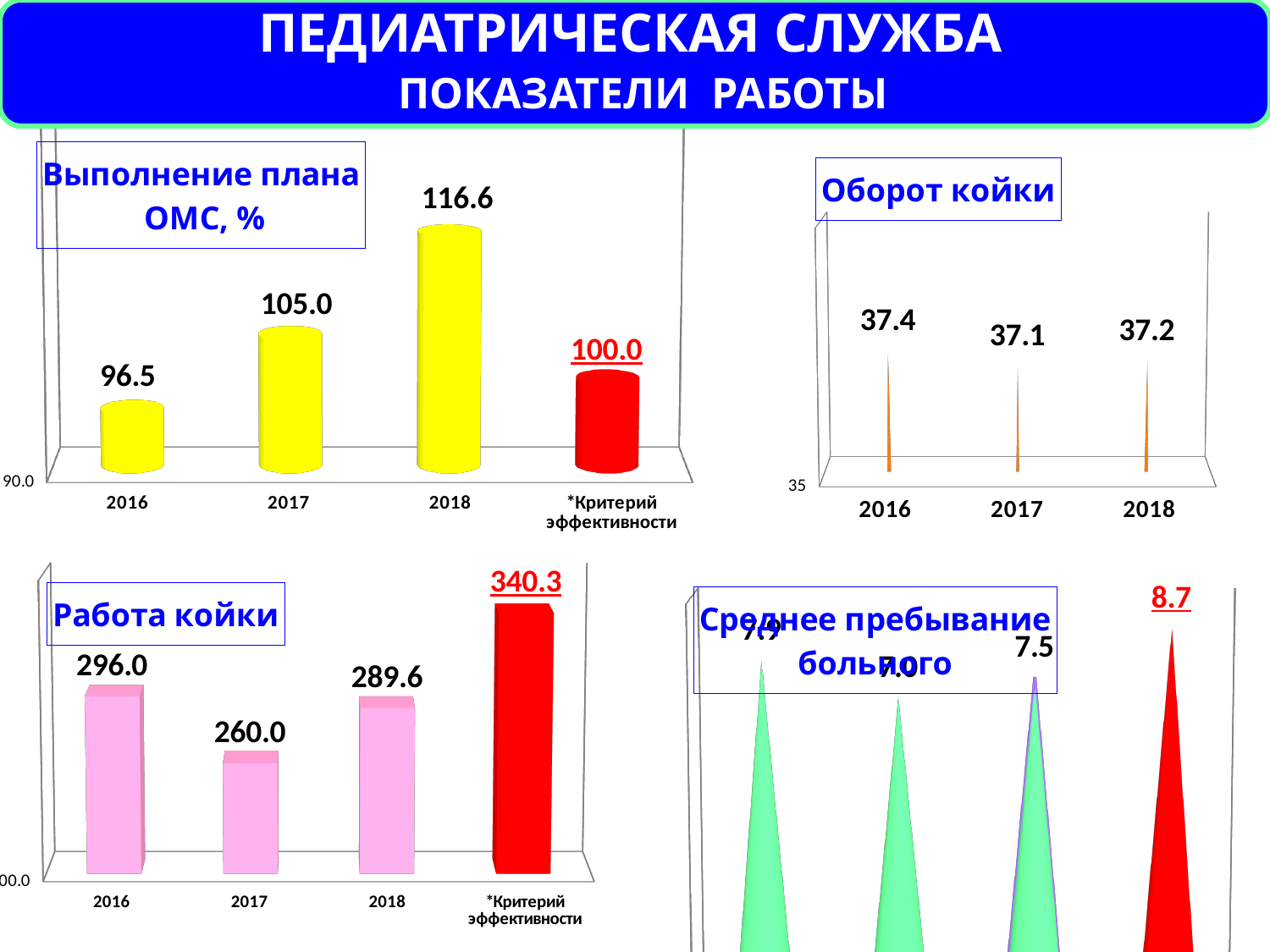
In the chart 'Оборот койки', how many years are shown? 3 What kind of chart is 'Выполнение плана ОМС, %'? bar chart In the chart 'Выполнение плана ОМС, %', how many bars are plotted? 4 In the chart 'Оборот койки', which year has the highest value? 2016 In the chart 'Выполнение плана ОМС, %', which year has the highest value? 2018 In the chart 'Выполнение плана ОМС, %', what is the value for 2016? 96.5 In the chart 'Выполнение плана ОМС, %', how much higher is the 2018 value than the 'Критерий эффективности' value? 16.6 In the chart 'Работа койки', which of the three years has the lowest value? 2017 In the chart 'Оборот койки', what is the value for 2017? 37.1 In the chart 'Выполнение плана ОМС, %', what is the value for 2018? 116.6 In the chart 'Работа койки', what is the value for 2017? 260.0 In the chart 'Работа койки', what is the difference between the 'Критерий эффективности' value and the 2016 value? 44.3